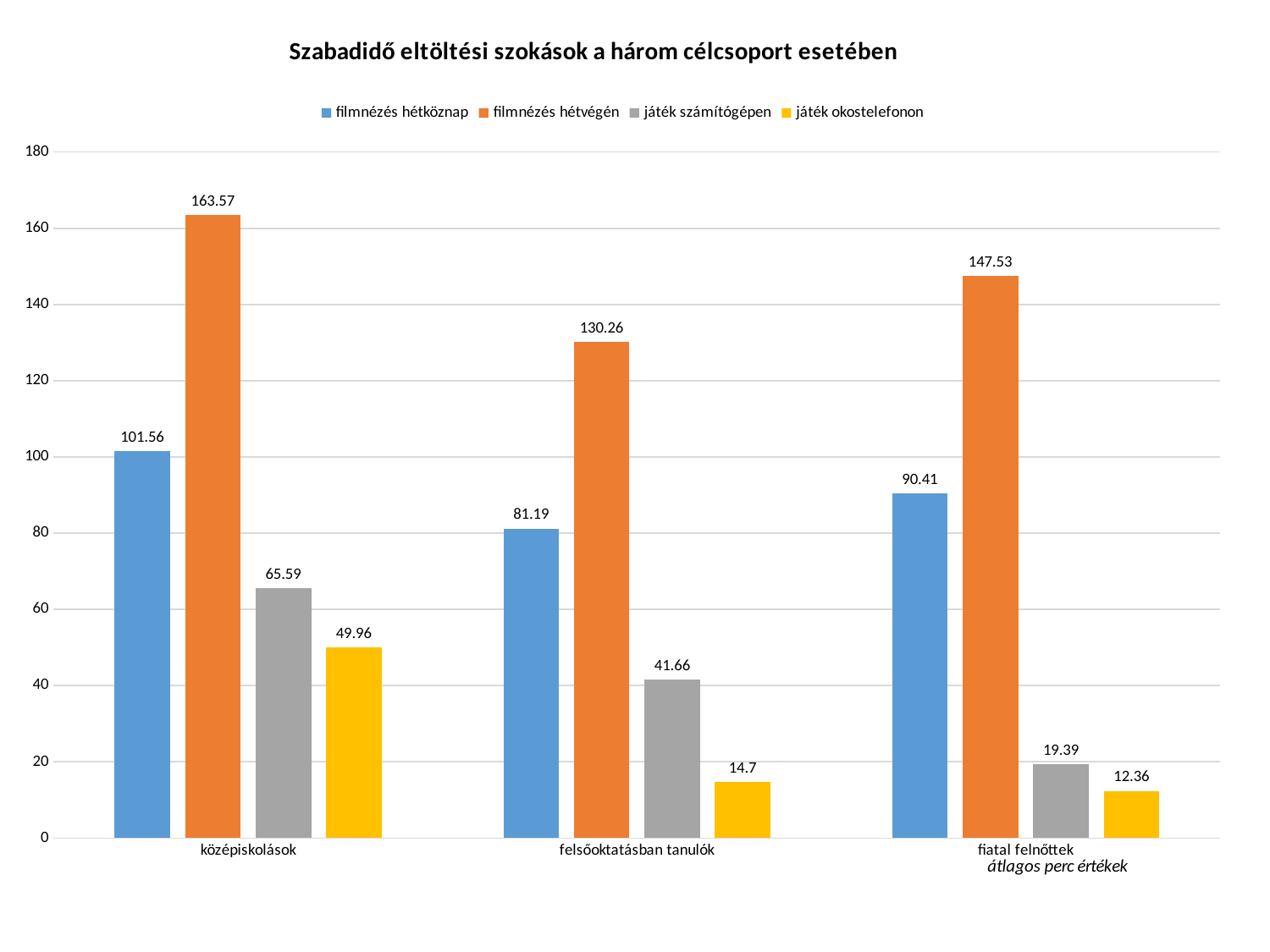
What kind of chart is shown on the slide? bar chart Which category has the highest value for filmnézés hétvégén? középiskolások What is the value for játék okostelefonon for felsőoktatásban tanulók? 14.7 What is the value for filmnézés hétköznap for fiatal felnőttek? 90.41 How many categories are shown on the x axis? 3 What is the value for filmnézés hétvégén for középiskolások? 163.57 Which is larger for felsőoktatásban tanulók: játék számítógépen or játék okostelefonon? játék számítógépen Which category has the lowest value for játék okostelefonon? fiatal felnőttek What is the difference between filmnézés hétvégén and filmnézés hétköznap for középiskolások? 62.01 How many series does the legend list? 4 What is the value for játék számítógépen for fiatal felnőttek? 19.39 What is the title of the chart? Szabadidő eltöltési szokások a három célcsoport esetében